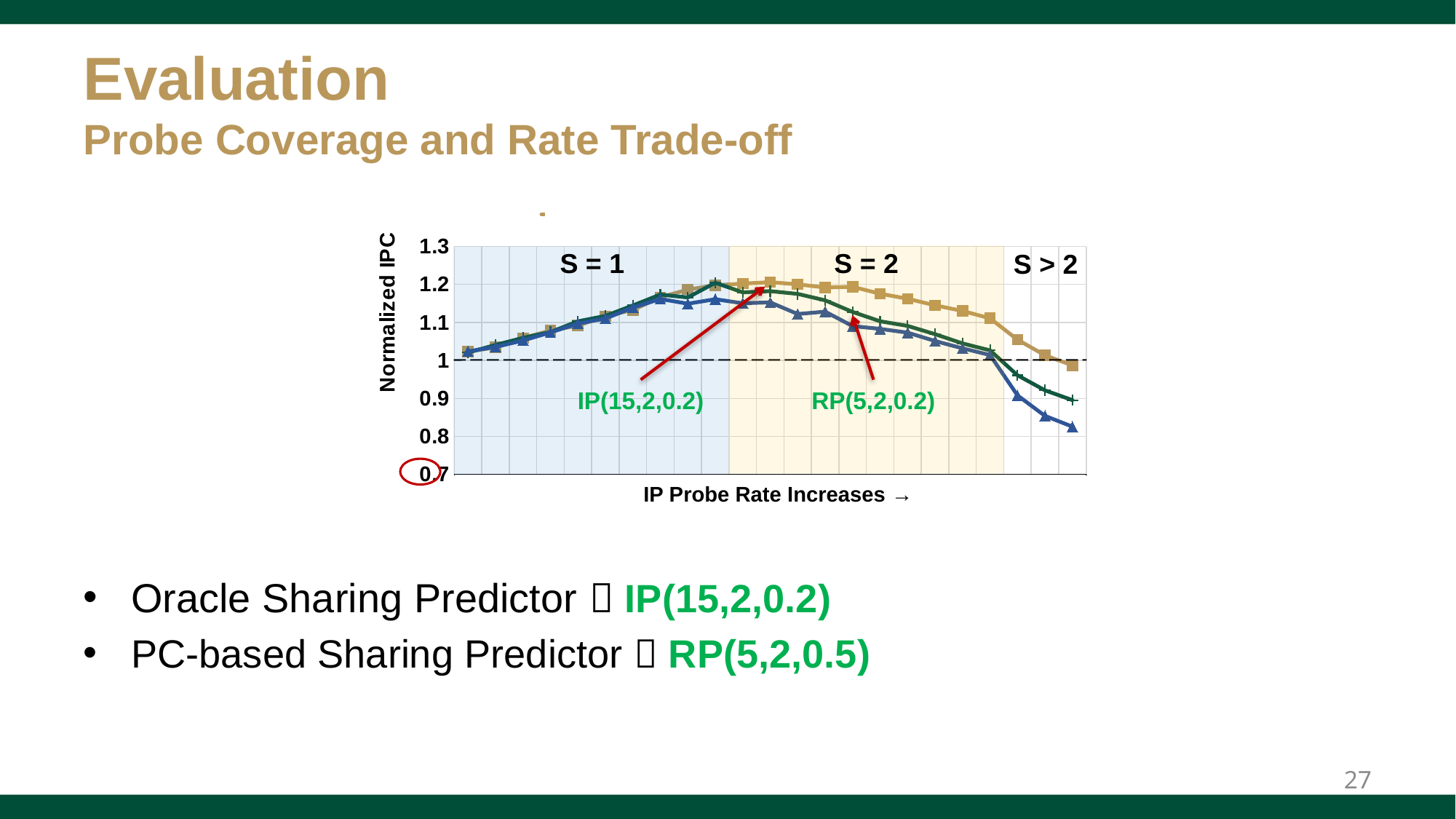
What kind of chart is shown on the slide? line chart How many shaded regions (S = 1, S = 2, S > 2) are marked on the chart? 3 Do the plotted values rise or fall along the x axis in the S > 2 region? fall How many data series are plotted on the chart? 3 What is the label of the x axis of the chart? IP Probe Rate Increases → At what Normalized IPC value is the dashed horizontal reference line drawn? 1 Is the final value of the blue triangle series greater or less than 0.9? less Which series has the lowest value at the right-hand end of the chart? the blue triangle series Which series has the highest values in the S = 2 region? the tan square series What is the label of the y axis of the chart? Normalized IPC Is the peak value of the blue triangle series greater or less than 1.1? greater At the right-hand end of the chart, which is larger: the tan square series or the blue triangle series? the tan square series